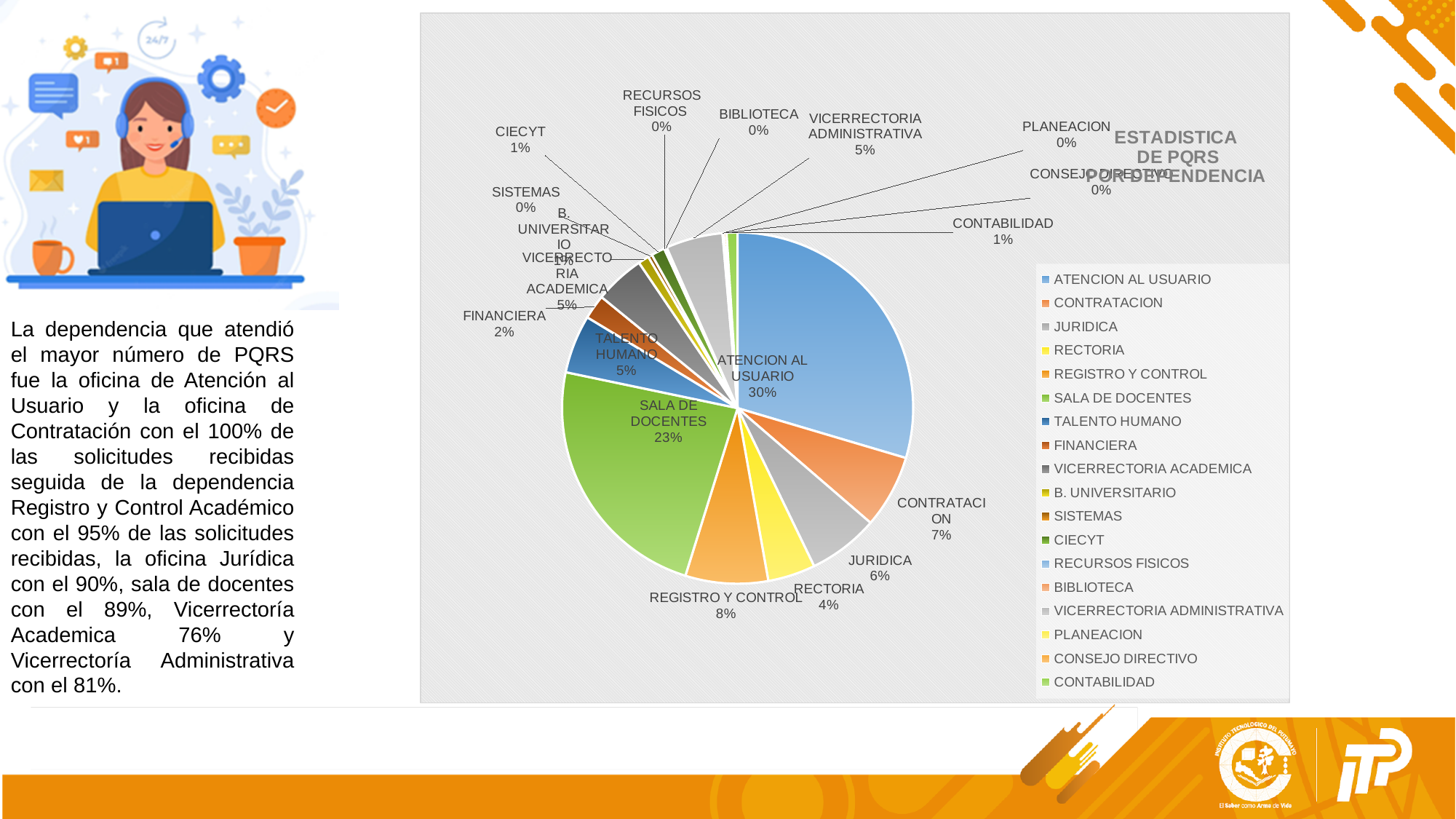
What is the value shown for REGISTRO Y CONTROL? 8% What is the value shown for CONTRATACION? 7% What is the title of the chart? ESTADISTICA DE PQRS POR DEPENDENCIA What share of the pie does SALA DE DOCENTES represent? 23% What is the difference between the shares of ATENCION AL USUARIO and SALA DE DOCENTES? 7% What is the value shown for JURIDICA? 6% What share of the pie does ATENCION AL USUARIO represent? 30% Which category has the largest slice of the pie? ATENCION AL USUARIO How many categories does the legend list? 18 What is the value shown for VICERRECTORIA ADMINISTRATIVA? 5% Which is larger, the share for RECTORIA or the share for TALENTO HUMANO? TALENTO HUMANO What kind of chart is shown on the slide? pie chart